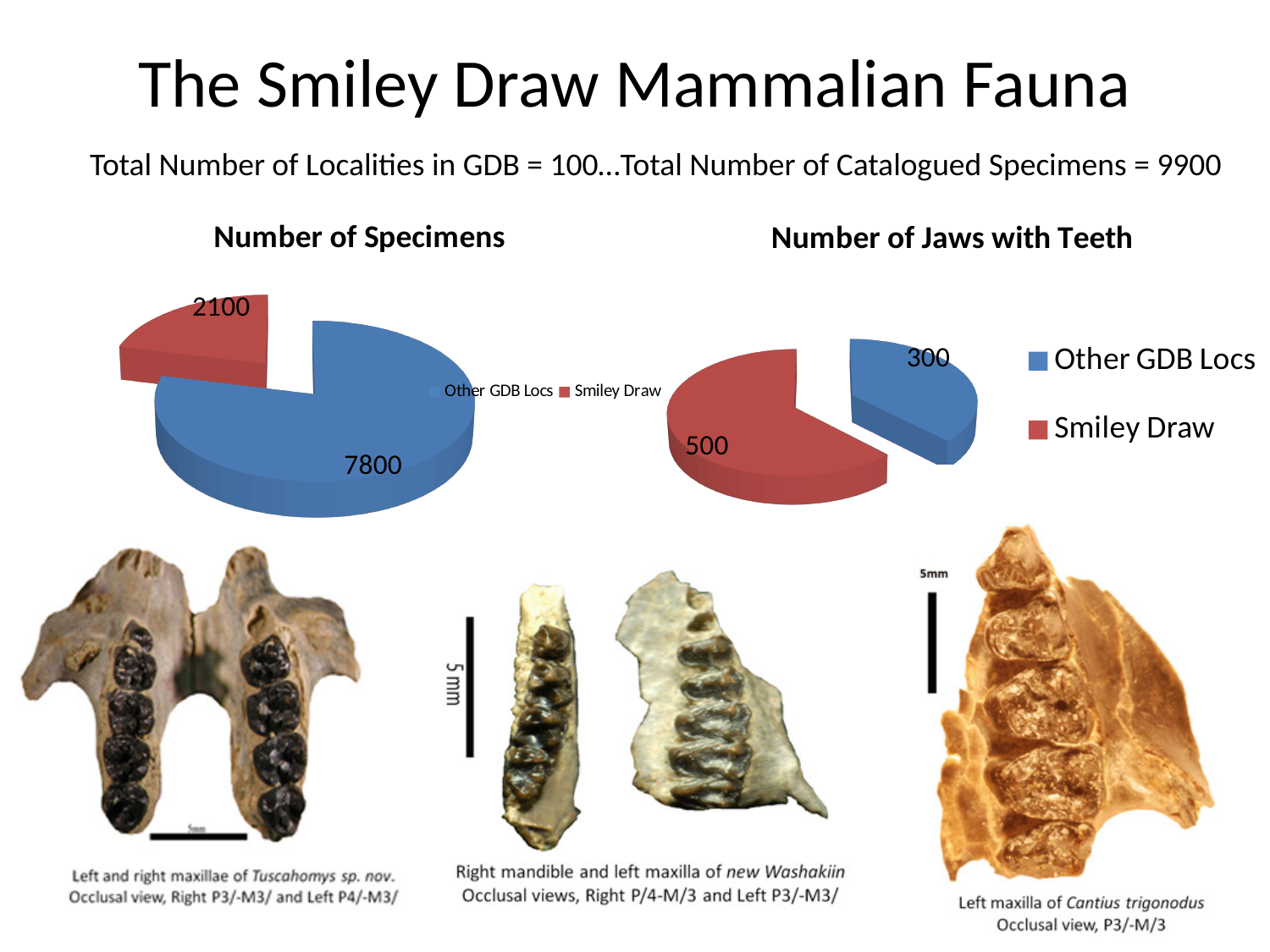
In the "Number of Jaws with Teeth" chart, which category has the smallest slice? Other GDB Locs How many series does the legend of the "Number of Jaws with Teeth" chart list? 2 In the "Number of Specimens" chart, what is the difference between Other GDB Locs and Smiley Draw? 5700 In the "Number of Specimens" chart, what is the value for Other GDB Locs? 7800 What kind of chart is the "Number of Specimens" chart? pie chart In the "Number of Jaws with Teeth" chart, what colour is the Smiley Draw slice? red In the "Number of Specimens" chart, what is the value for Smiley Draw? 2100 In the "Number of Jaws with Teeth" chart, which is larger, Smiley Draw or Other GDB Locs? Smiley Draw In the "Number of Jaws with Teeth" chart, what is the difference between Smiley Draw and Other GDB Locs? 200 In the "Number of Specimens" chart, which category has the largest slice? Other GDB Locs In the "Number of Jaws with Teeth" chart, what is the value for Smiley Draw? 500 In the "Number of Jaws with Teeth" chart, what is the value for Other GDB Locs? 300